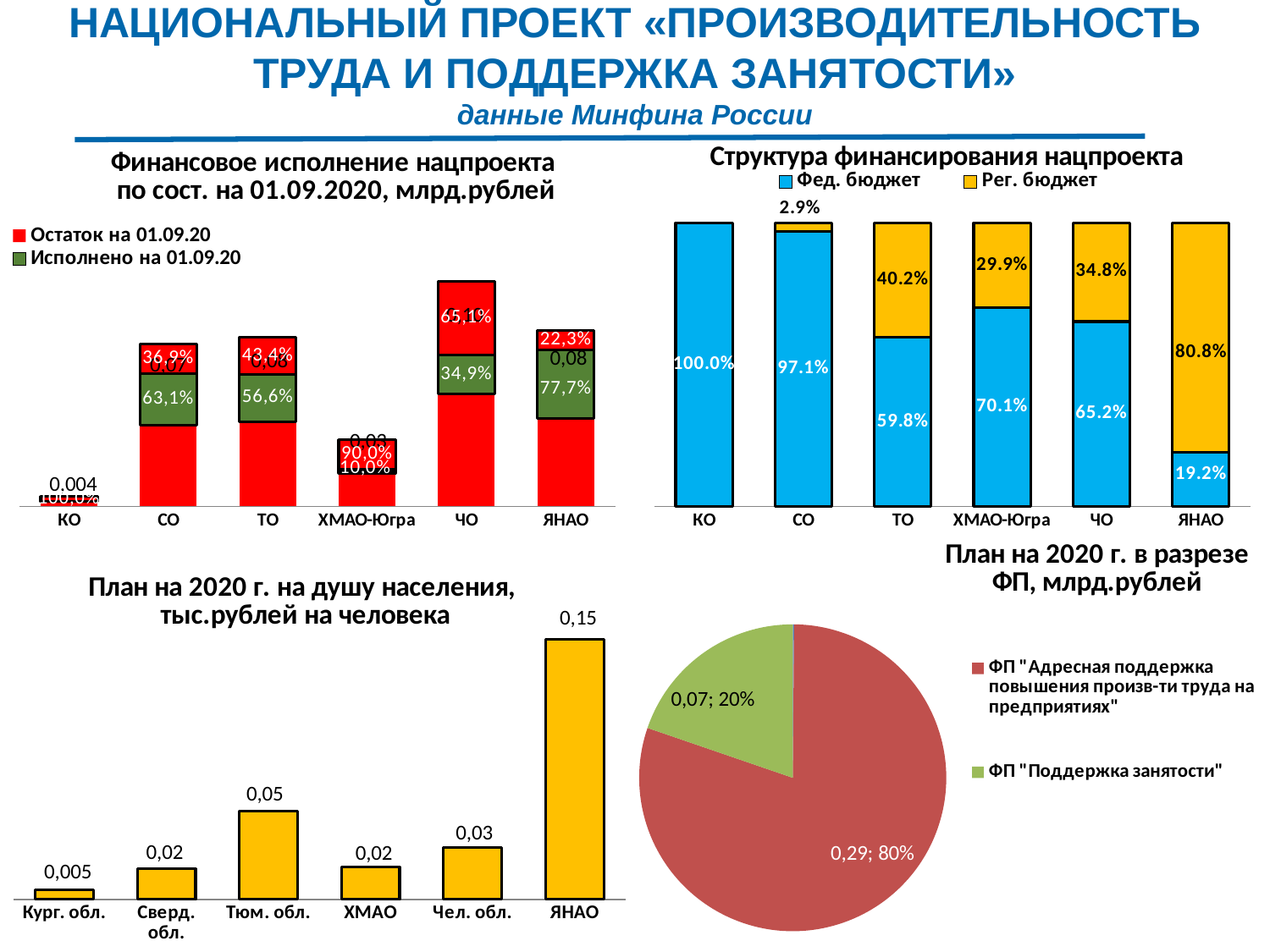
What kind of chart is 'План на 2020 г. в разрезе ФП, млрд.рублей'? Pie chart In the chart 'Структура финансирования нацпроекта', what is the share of Рег. бюджет for ТО? 40.2% In the chart 'Структура финансирования нацпроекта', which region has the highest share of Рег. бюджет? ЯНАО In the pie chart 'План на 2020 г. в разрезе ФП, млрд.рублей', what share does ФП "Поддержка занятости" have? 20% In the chart 'План на 2020 г. на душу населения, тыс.рублей на человека', which region has the highest value? ЯНАО In the chart 'Структура финансирования нацпроекта', what is the share of Фед. бюджет for ЯНАО? 19.2% In the chart 'План на 2020 г. на душу населения, тыс.рублей на человека', how many regions are shown? 6 In the chart 'Структура финансирования нацпроекта', how many series does the legend list? 2 In the chart 'План на 2020 г. на душу населения, тыс.рублей на человека', which region has the lowest value? Кург. обл. In the chart 'Структура финансирования нацпроекта', what is the difference between the Фед. бюджет shares of ХМАО-Югра and ЧО? 4.9% In the chart 'План на 2020 г. на душу населения, тыс.рублей на человека', what is the difference between the values for ЯНАО and Чел. обл.? 0,12 In the chart 'План на 2020 г. на душу населения, тыс.рублей на человека', what is the value for Тюм. обл.? 0,05